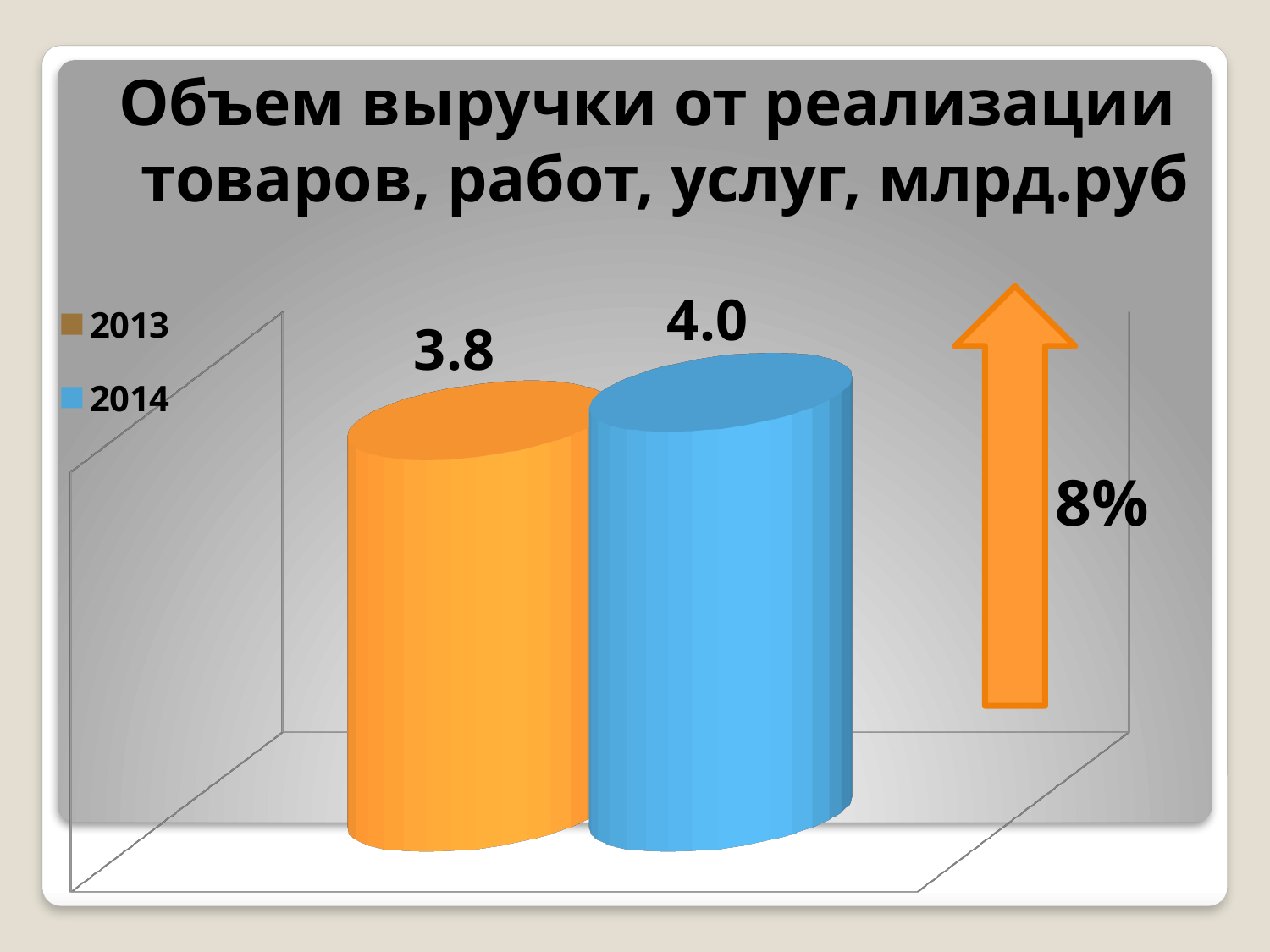
How many series does the legend list? 2 How many bars are plotted on the chart? 2 Which year has the lowest value? 2013 What is the value for 2014? 4.0 What percentage change is shown next to the arrow on the slide? 8% What kind of chart is shown on the slide? bar chart Do the values rise or fall from 2013 to 2014? rise Which year has the higher value, 2013 or 2014? 2014 What is the title of the chart? Объем выручки от реализации товаров, работ, услуг, млрд.руб What is the difference between the 2014 and 2013 values? 0.2 What is the value for 2013? 3.8 Which year has the highest value? 2014